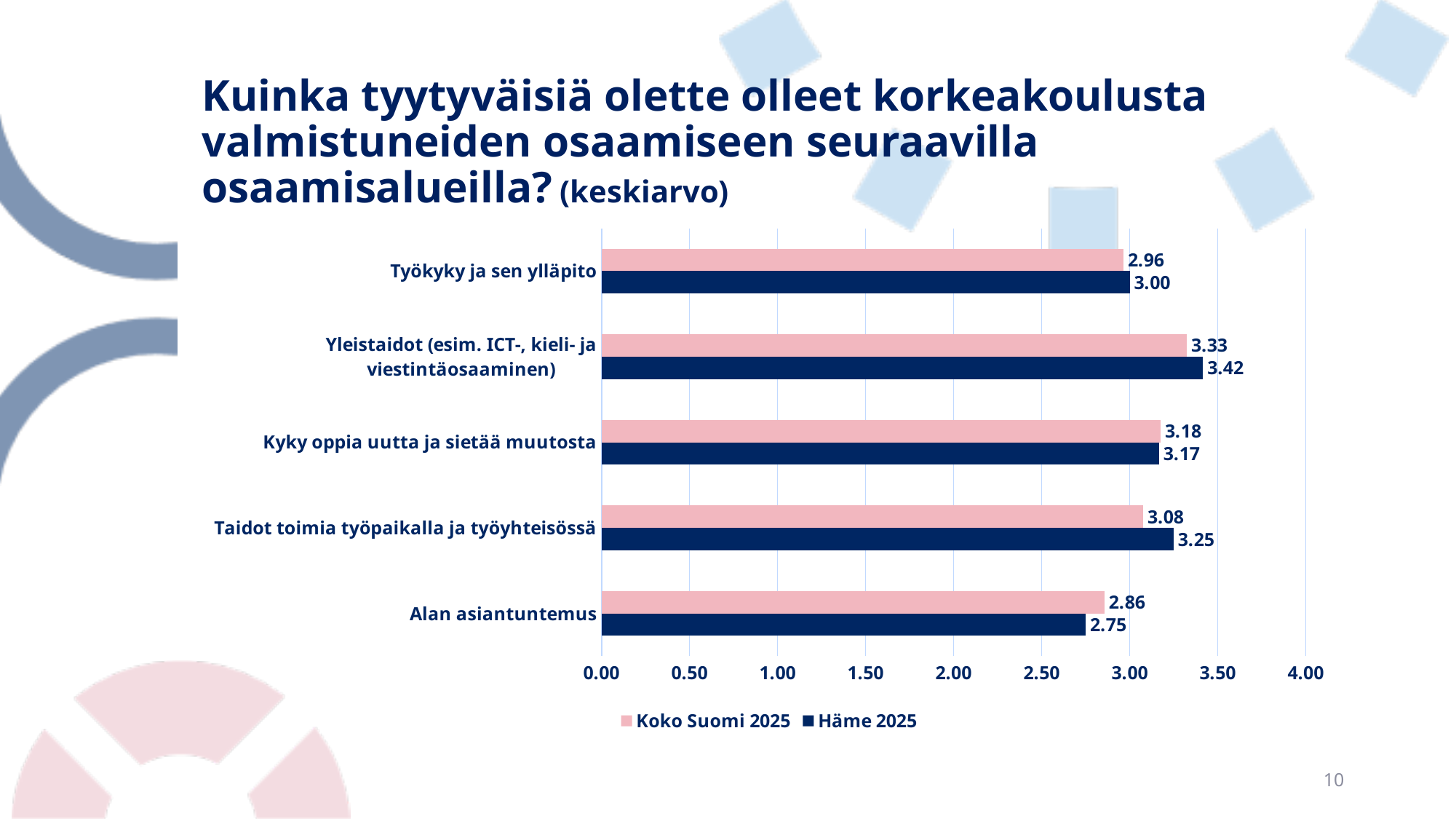
What is the Häme 2025 value for Yleistaidot (esim. ICT-, kieli- ja viestintäosaaminen)? 3.42 What is the Koko Suomi 2025 value for Alan asiantuntemus? 2.86 What kind of chart is shown on the slide? Bar chart What is the Häme 2025 value for Taidot toimia työpaikalla ja työyhteisössä? 3.25 Which category has the highest Häme 2025 value? Yleistaidot (esim. ICT-, kieli- ja viestintäosaaminen) Which category has the lowest Koko Suomi 2025 value? Alan asiantuntemus How many categories are shown on the chart? 5 For Alan asiantuntemus, which is larger: the Koko Suomi 2025 value or the Häme 2025 value? Koko Suomi 2025 How many series does the legend list? 2 Is the Häme 2025 value for Työkyky ja sen ylläpito greater or less than 2.50? greater What is the difference between the Häme 2025 and Koko Suomi 2025 values for Taidot toimia työpaikalla ja työyhteisössä? 0.17 Which series is shown in dark blue? Häme 2025